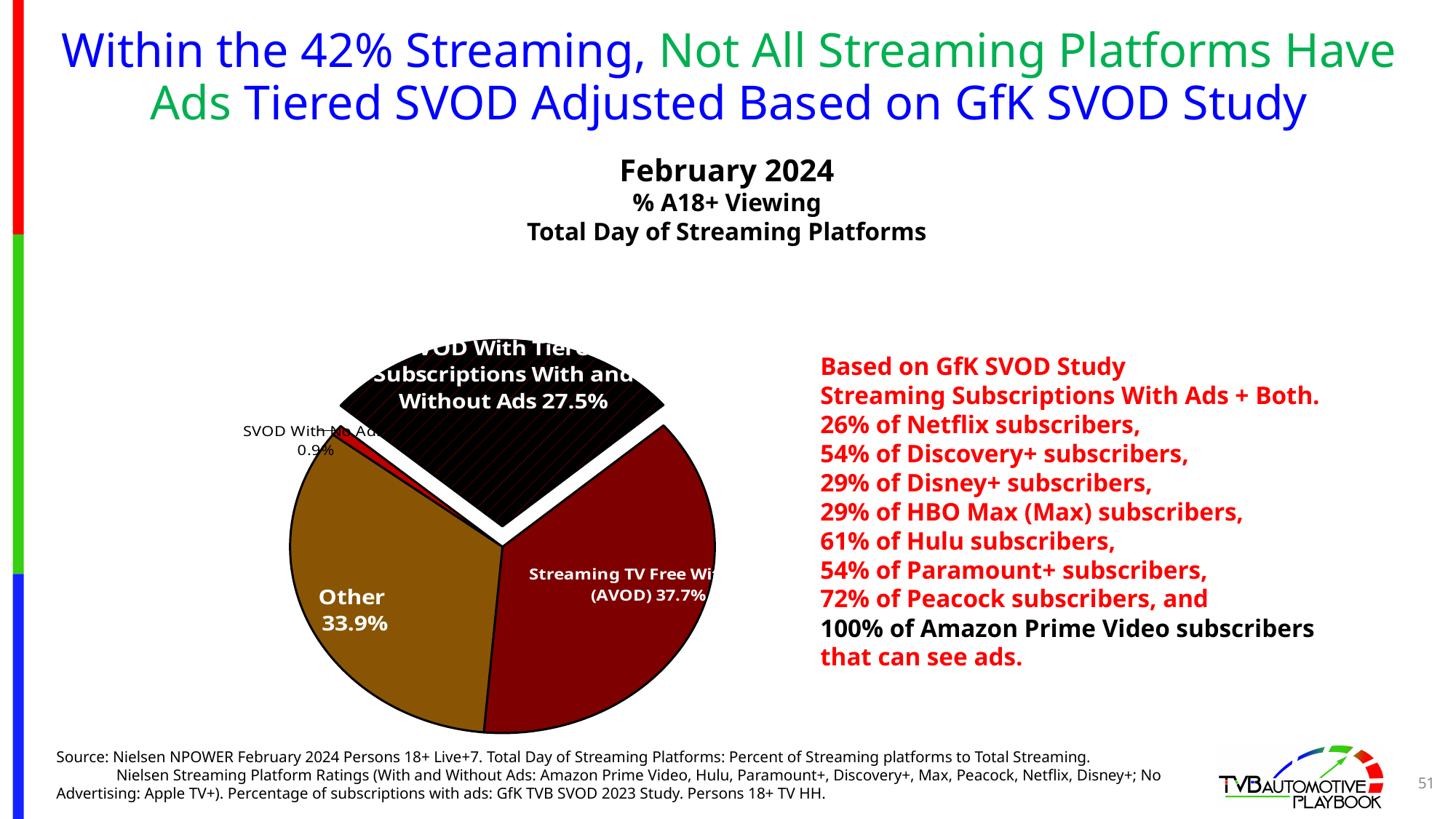
What is the difference between the SVOD With Tiered Subscriptions With and Without Ads slice and the SVOD With No Ads slice? 26.6% What kind of chart is shown on the slide? Pie chart Which is larger, the Other slice or the SVOD With Tiered Subscriptions With and Without Ads slice? Other What is the difference between the Streaming TV Free With Ads (AVOD) slice and the Other slice? 3.8% What is the value shown for the Streaming TV Free With Ads (AVOD) slice? 37.7% What percentage is shown for SVOD With Tiered Subscriptions With and Without Ads? 27.5% How many slices does the pie chart have? 4 What share of the pie does the "Other" slice represent? 33.9% What month and year does the chart subtitle give for the data? February 2024 What is the value shown for the SVOD With No Ads slice? 0.9% Which slice of the pie is the smallest? SVOD With No Ads Which slice of the pie is the largest? Streaming TV Free With Ads (AVOD)